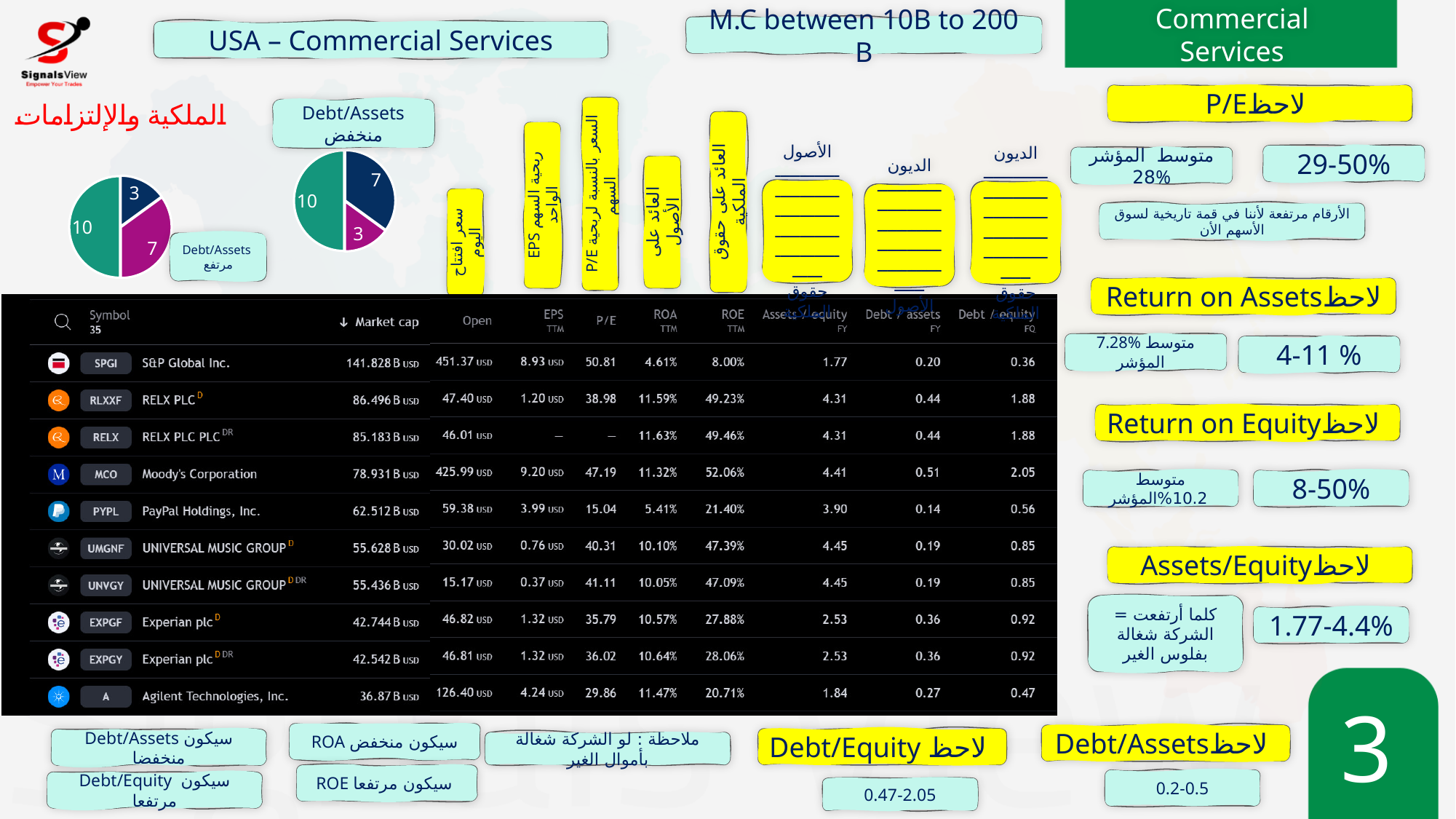
In the right pie chart (labelled "Debt/Assets منخفض"), what value is shown on the magenta slice? 3 How many pie charts are shown on the slide? 2 What kind of chart is the chart labelled "Debt/Assets مرتفع" on the left of the slide? pie chart In the left pie chart (labelled "Debt/Assets مرتفع"), which colour slice is the largest? teal In the left pie chart (labelled "Debt/Assets مرتفع"), what value is shown on the magenta slice? 7 In the right pie chart (labelled "Debt/Assets منخفض"), which colour slice is the smallest? magenta In the right pie chart (labelled "Debt/Assets منخفض"), which is larger, the dark blue slice or the magenta slice? dark blue In the left pie chart (labelled "Debt/Assets مرتفع"), what share of the total does the teal slice represent? 50% How many slices does the left pie chart (labelled "Debt/Assets مرتفع") have? 3 In the left pie chart (labelled "Debt/Assets مرتفع"), what value is shown on the teal slice? 10 In the left pie chart (labelled "Debt/Assets مرتفع"), what is the difference between the teal slice and the dark blue slice? 7 In the right pie chart (labelled "Debt/Assets منخفض"), what value is shown on the dark blue slice? 7